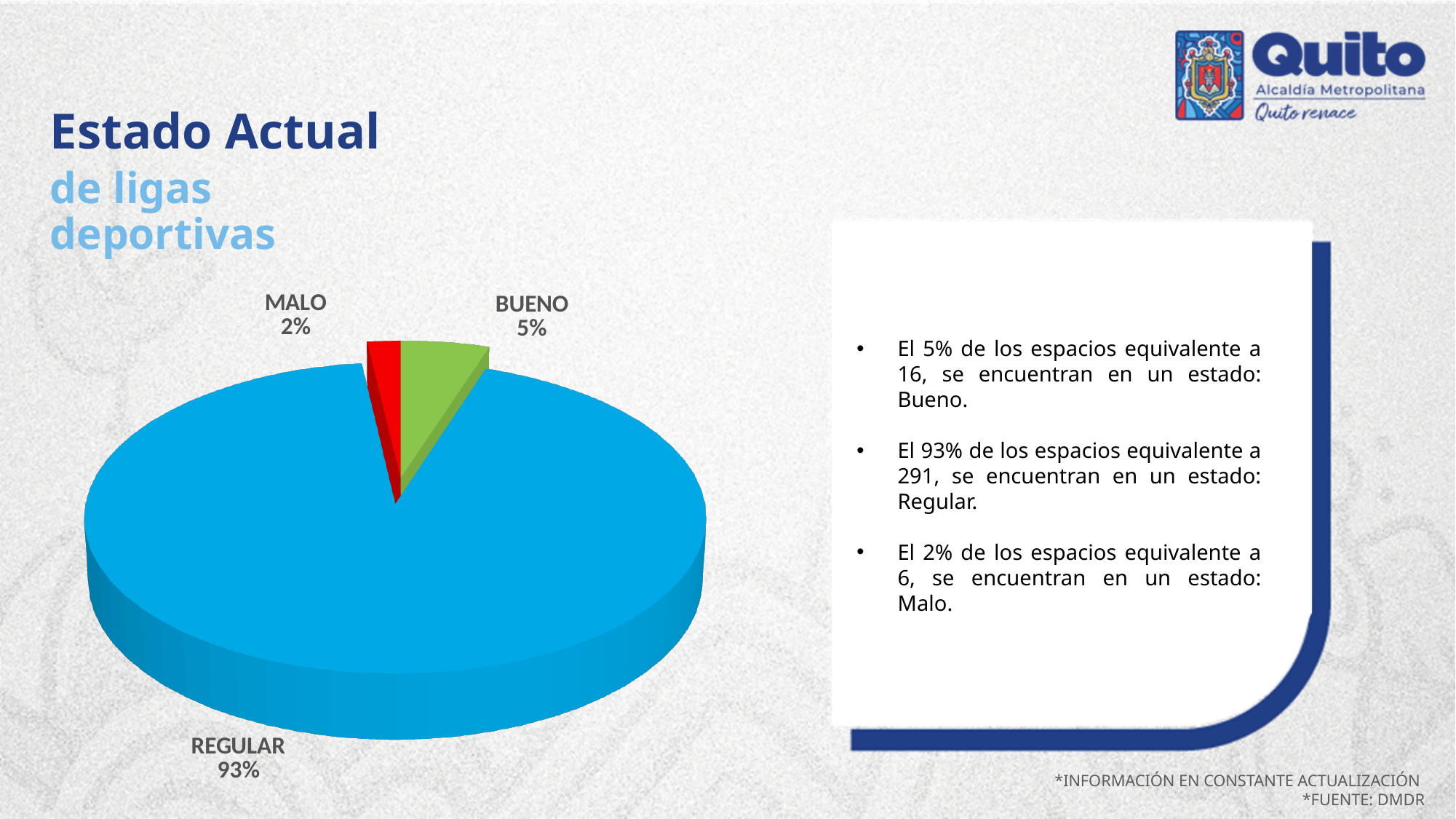
What colour is the REGULAR slice? blue What share of the pie does MALO represent? 2% What is the difference in percentage points between BUENO and MALO? 3 What is the difference in percentage points between REGULAR and BUENO? 88 What share of the pie does BUENO represent? 5% How many slices does the pie chart have? 3 Which is larger, the BUENO slice or the MALO slice? BUENO Which category has the largest slice of the pie? REGULAR What colour is the MALO slice? red What kind of chart is shown on the slide? pie chart Which category has the smallest slice of the pie? MALO What share of the pie does REGULAR represent? 93%